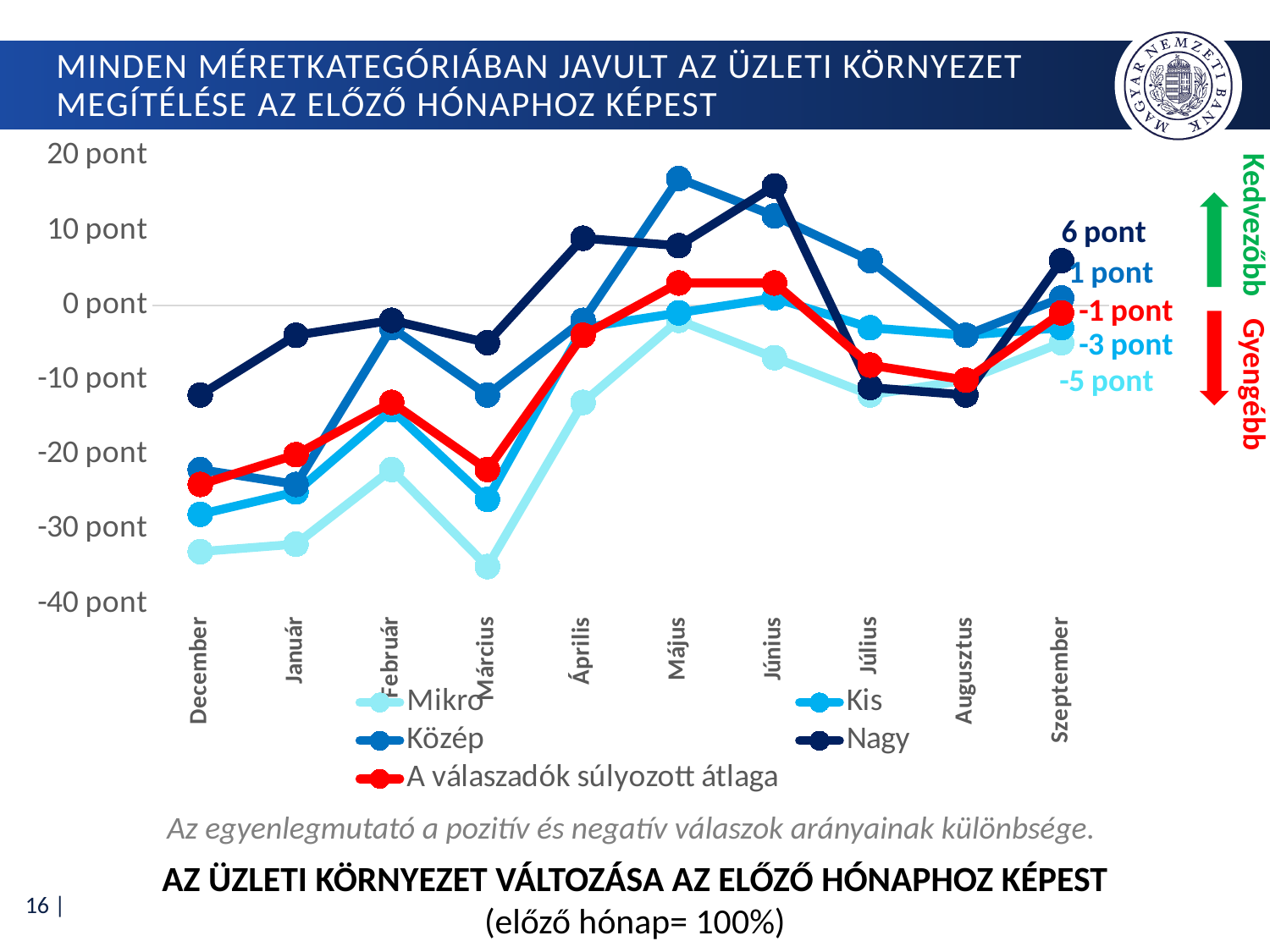
What is the value for A válaszadók súlyozott átlaga in Szeptember? -1 pont In Szeptember, which is larger: the value for Közép or the value for Kis? Közép Is the value for Mikro in Március greater or less than -30 pont? less What is the value for Kis in Szeptember? -3 pont How many series does the legend list? 5 Which series has the lowest value in Szeptember? Mikro What is the value for Nagy in Szeptember? 6 pont Which series has the highest value in Szeptember? Nagy What is the value for Mikro in Szeptember? -5 pont What is the difference between the Nagy and Mikro values in Szeptember? 11 pont Is the value for Közép in Május greater or less than 10 pont? greater How many months are shown on the x axis? 10